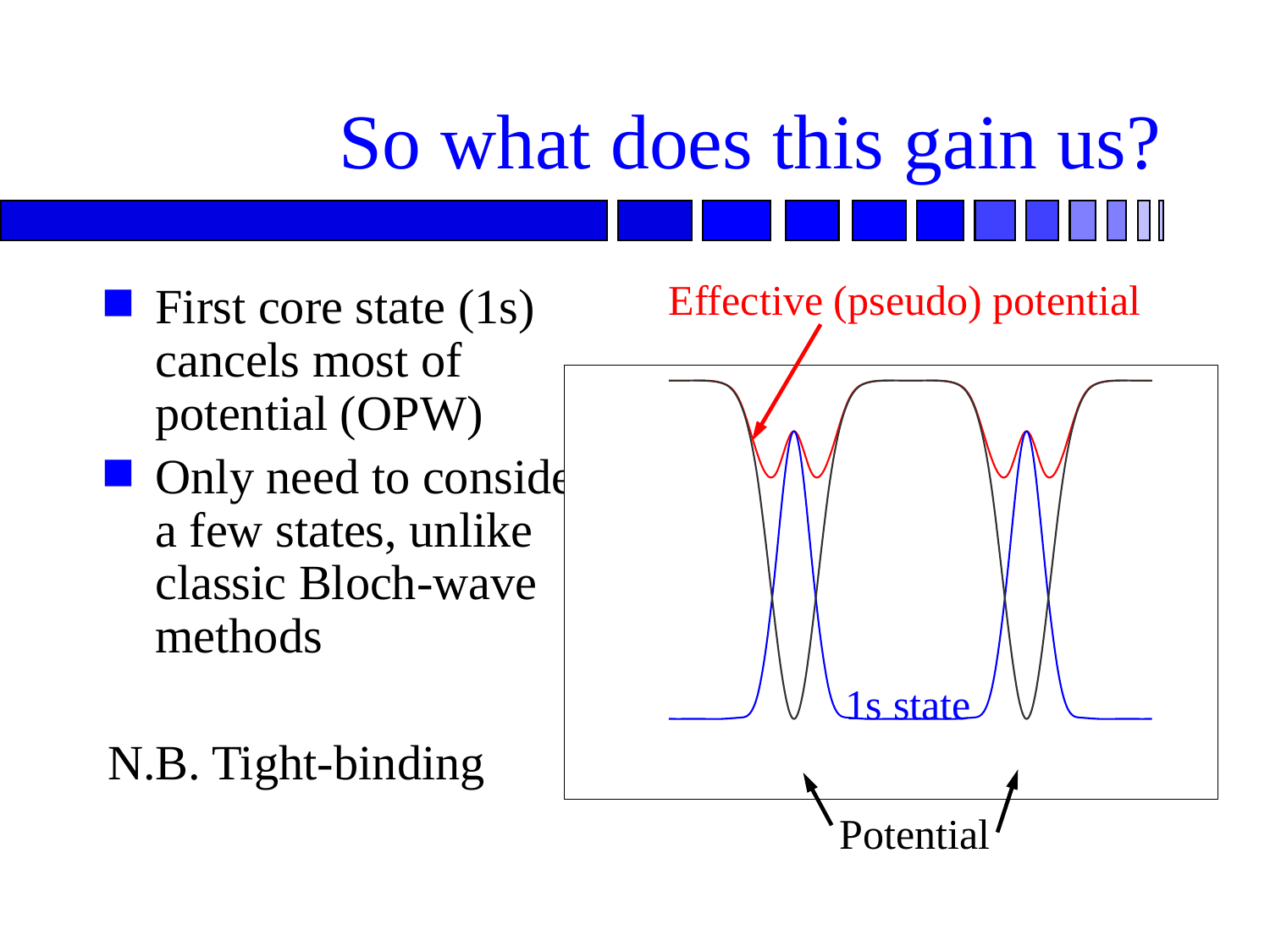
What kind of chart is shown on the slide? line chart How many peaks does the 1s state curve have? 2 What colour is the curve labelled Effective (pseudo) potential? red Which curve dips lower at the well positions, the Potential or the Effective (pseudo) potential? Potential How many wells (dips) does the Potential curve have? 2 What colour is the curve labelled 1s state? blue How many labelled curves are plotted in the chart? 3